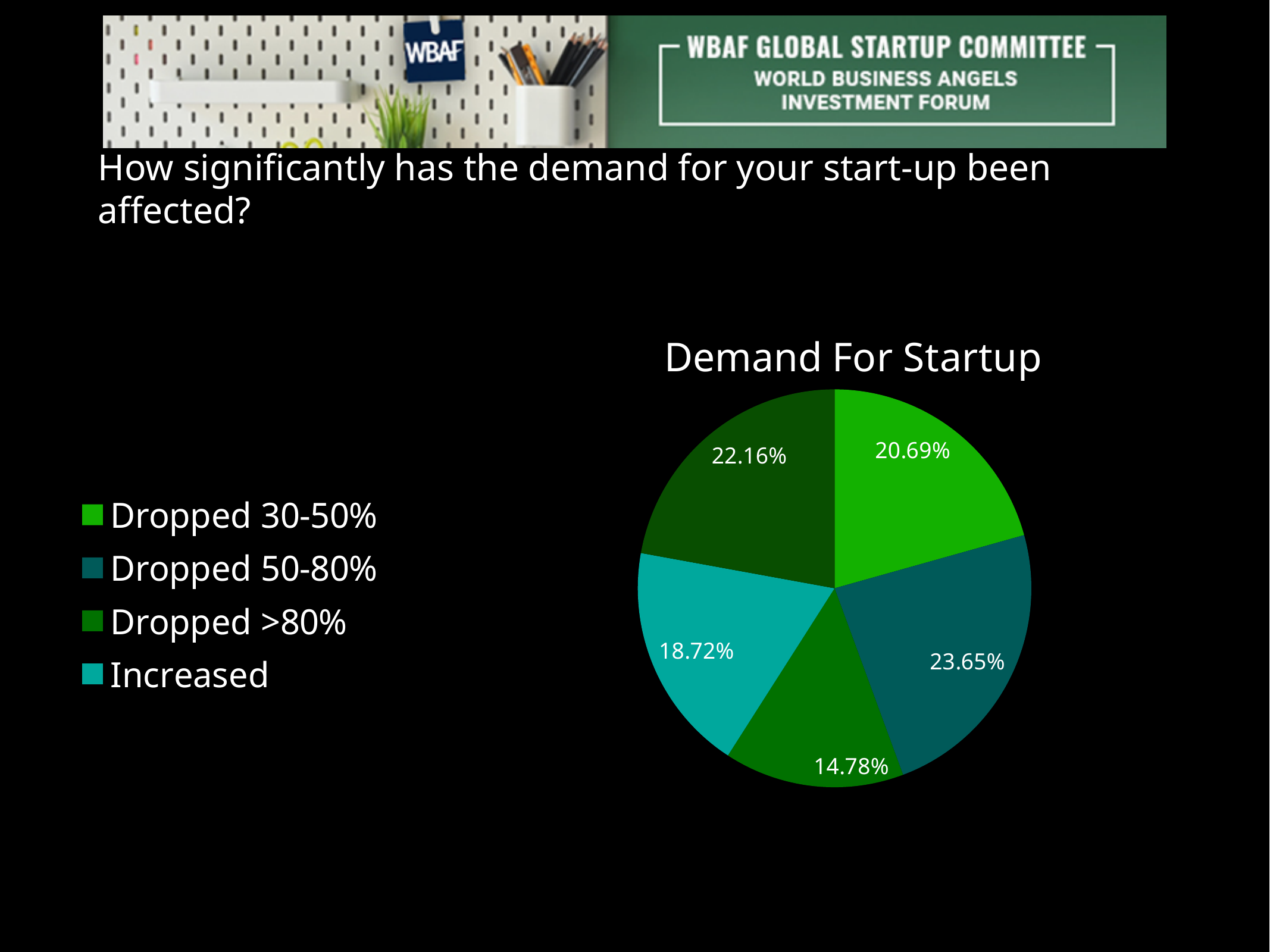
Which is larger, the Dropped 30-50% slice or the Increased slice? Dropped 30-50% What is the value shown for the Dropped >80% slice? 14.78% What is the difference in percentage points between the Increased slice and the Dropped >80% slice? 3.94% What is the difference in percentage points between the Dropped 50-80% slice and the Dropped 30-50% slice? 2.96% What kind of chart is shown on the slide? Pie chart What is the value shown for the Dropped 50-80% slice? 23.65% Which legend category has the largest slice of the pie? Dropped 50-80% What is the value shown for the Increased slice? 18.72% How many slices does the pie chart have? 5 What share of the pie does the Dropped 30-50% slice represent? 20.69% What is the title of the chart? Demand For Startup Which legend category has the smallest slice of the pie? Dropped >80%